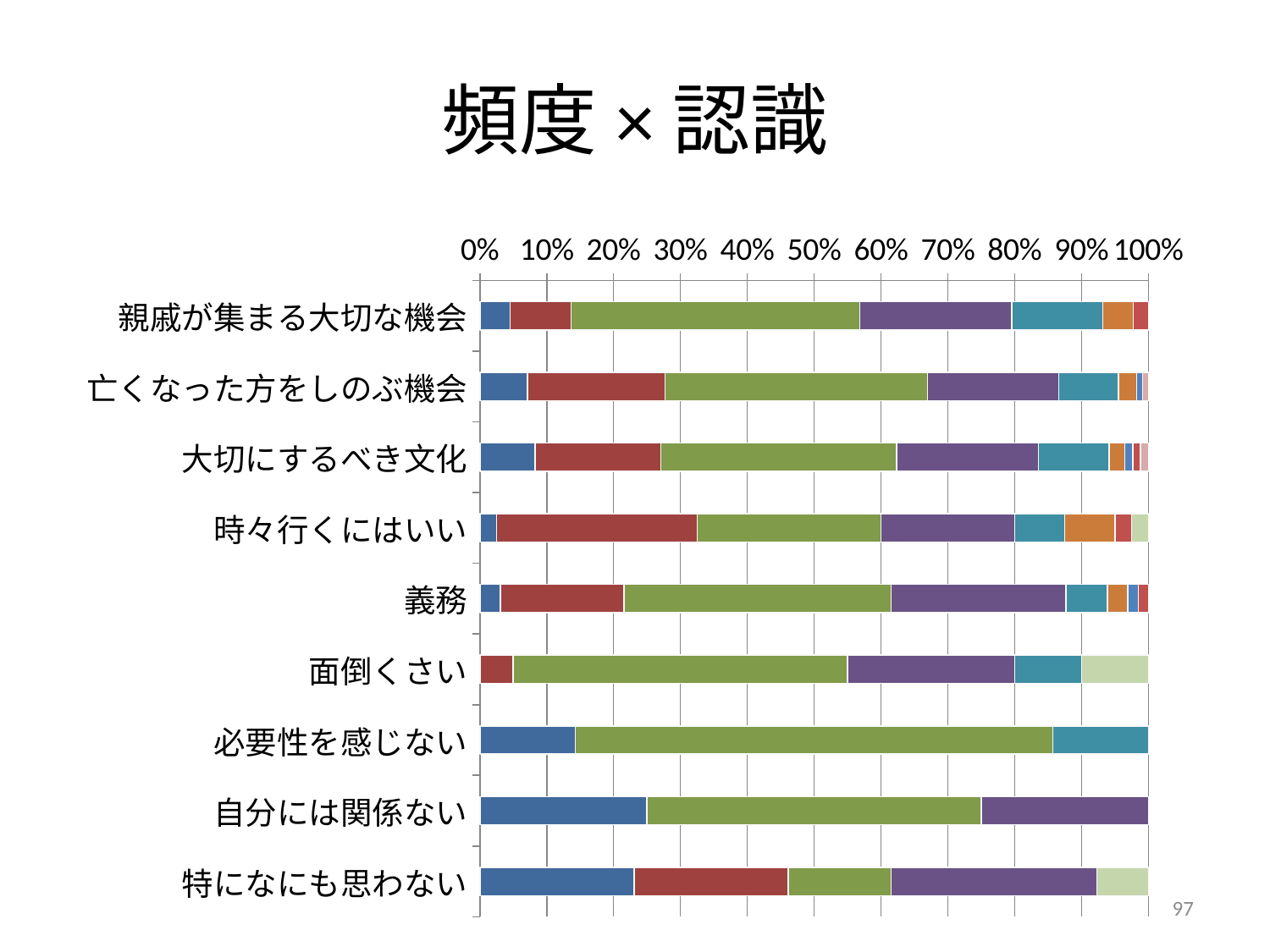
Is the green segment for 必要性を感じない greater or less than 60%? greater Is the purple segment for 自分には関係ない greater or less than 20%? greater How many segments make up the bar for 自分には関係ない? 3 How many categories are plotted on the chart? 9 Is the blue segment for 必要性を感じない greater or less than 20%? less Which is larger, the blue segment for 自分には関係ない or the blue segment for 親戚が集まる大切な機会? 自分には関係ない What is the maximum value shown on the horizontal axis? 100% What is the title of the chart slide? 頻度 × 認識 What kind of chart is shown on the slide? Stacked bar chart Which category has the largest red segment? 時々行くにはいい Which category has the largest green segment? 必要性を感じない